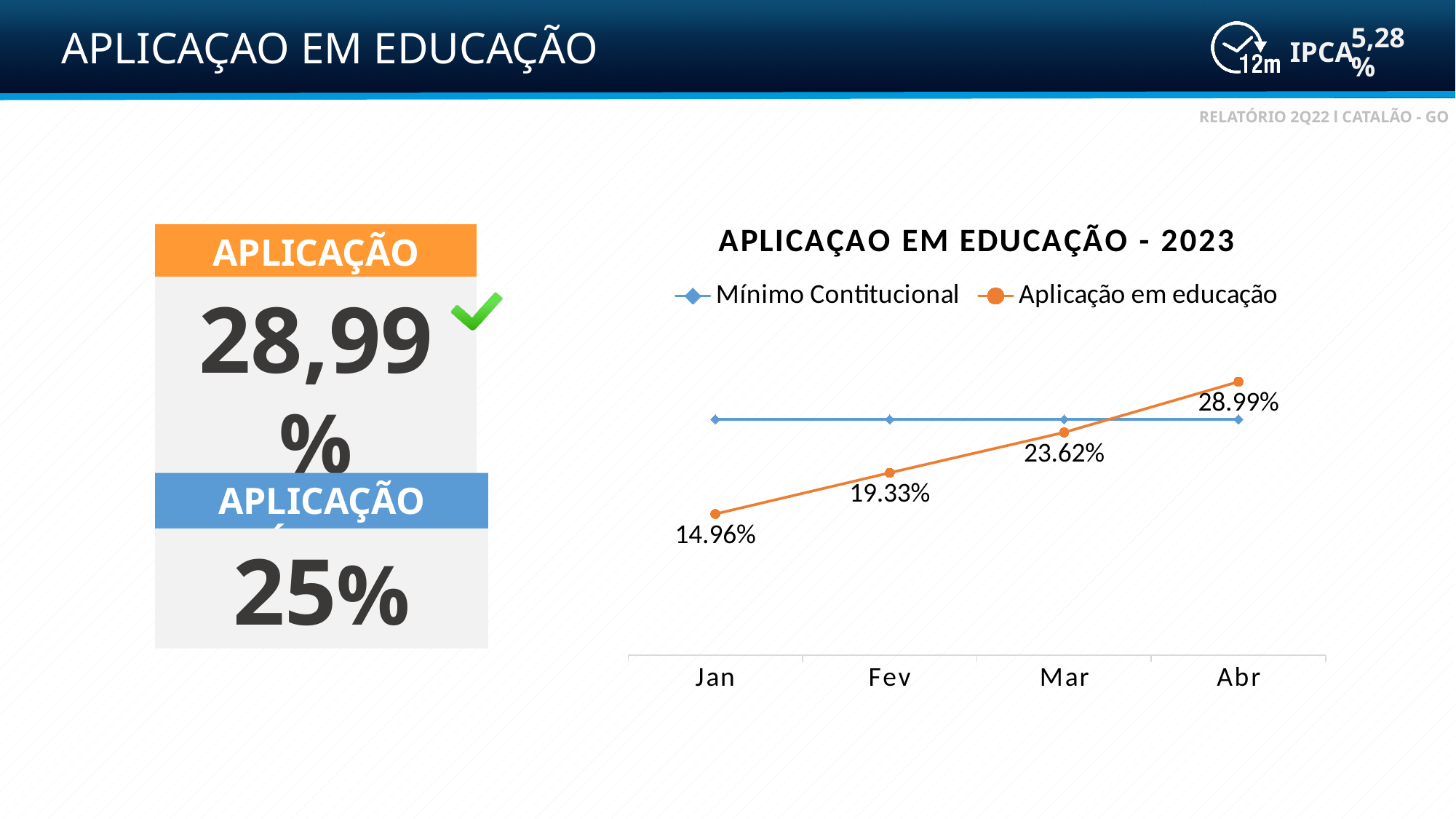
What is the value of Aplicação em educação in Abr? 28.99% What is the value of Aplicação em educação in Mar? 23.62% How many months are shown on the x axis of the chart? 4 In which month is Aplicação em educação highest? Abr What is the value of Aplicação em educação in Fev? 19.33% In which month is Aplicação em educação lowest? Jan What is the value of Aplicação em educação in Jan? 14.96% What kind of chart is shown on the slide? Line chart Which is larger in Jan: Aplicação em educação or Mínimo Contitucional? Mínimo Contitucional How many series does the chart legend list? 2 What is the difference between Aplicação em educação in Abr and in Jan? 14.03 percentage points Which is larger in Abr: Aplicação em educação or Mínimo Contitucional? Aplicação em educação